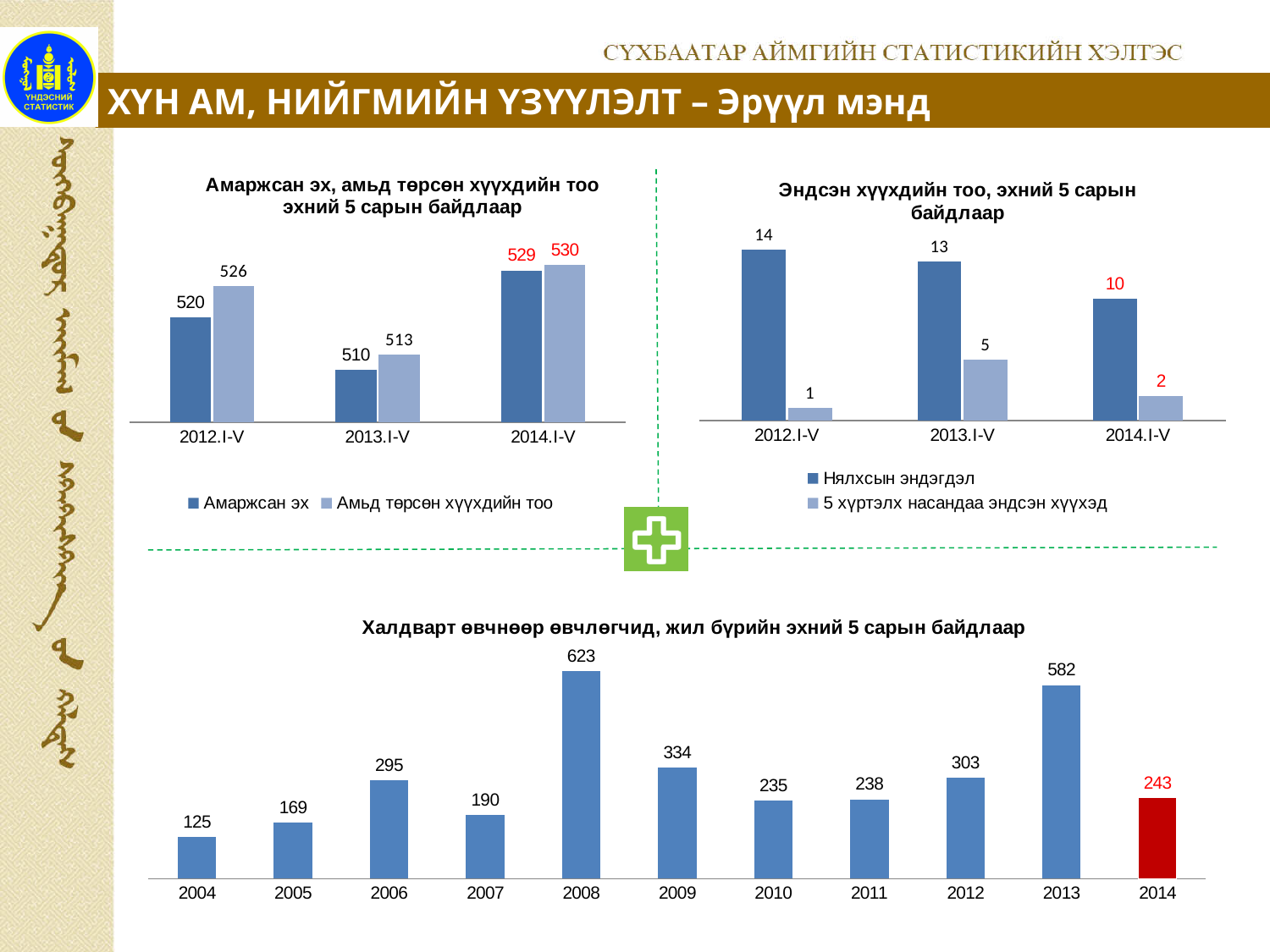
In the top-right chart 'Эндсэн хүүхдийн тоо, эхний 5 сарын байдлаар', does the value of 'Нялхсын эндэгдэл' rise or fall from 2012.I-V to 2014.I-V? fall In the bottom chart 'Халдварт өвчнөөр өвчлөгчид, жил бүрийн эхний 5 сарын байдлаар', how many years are shown on the x axis? 11 In the bottom chart 'Халдварт өвчнөөр өвчлөгчид, жил бүрийн эхний 5 сарын байдлаар', what is the difference between the values for 2013 and 2014? 339 In the bottom chart 'Халдварт өвчнөөр өвчлөгчид, жил бүрийн эхний 5 сарын байдлаар', what is the value for 2008? 623 In the bottom chart 'Халдварт өвчнөөр өвчлөгчид, жил бүрийн эхний 5 сарын байдлаар', which year has the highest value? 2008 In the top-left chart 'Амаржсан эх, амьд төрсөн хүүхдийн тоо эхний 5 сарын байдлаар', how many series does the legend list? 2 In the top-left chart 'Амаржсан эх, амьд төрсөн хүүхдийн тоо эхний 5 сарын байдлаар', what is the value of 'Амьд төрсөн хүүхдийн тоо' for 2014.I-V? 530 In the top-left chart 'Амаржсан эх, амьд төрсөн хүүхдийн тоо эхний 5 сарын байдлаар', what is the value of 'Амаржсан эх' for 2013.I-V? 510 In the bottom chart 'Халдварт өвчнөөр өвчлөгчид, жил бүрийн эхний 5 сарын байдлаар', which year has the lowest value? 2004 In the top-right chart 'Эндсэн хүүхдийн тоо, эхний 5 сарын байдлаар', what is the value of 'Нялхсын эндэгдэл' for 2012.I-V? 14 In the top-right chart 'Эндсэн хүүхдийн тоо, эхний 5 сарын байдлаар', which period has the highest value for '5 хүртэлх насандаа эндсэн хүүхэд'? 2013.I-V What kind of chart is the bottom chart 'Халдварт өвчнөөр өвчлөгчид, жил бүрийн эхний 5 сарын байдлаар'? bar chart